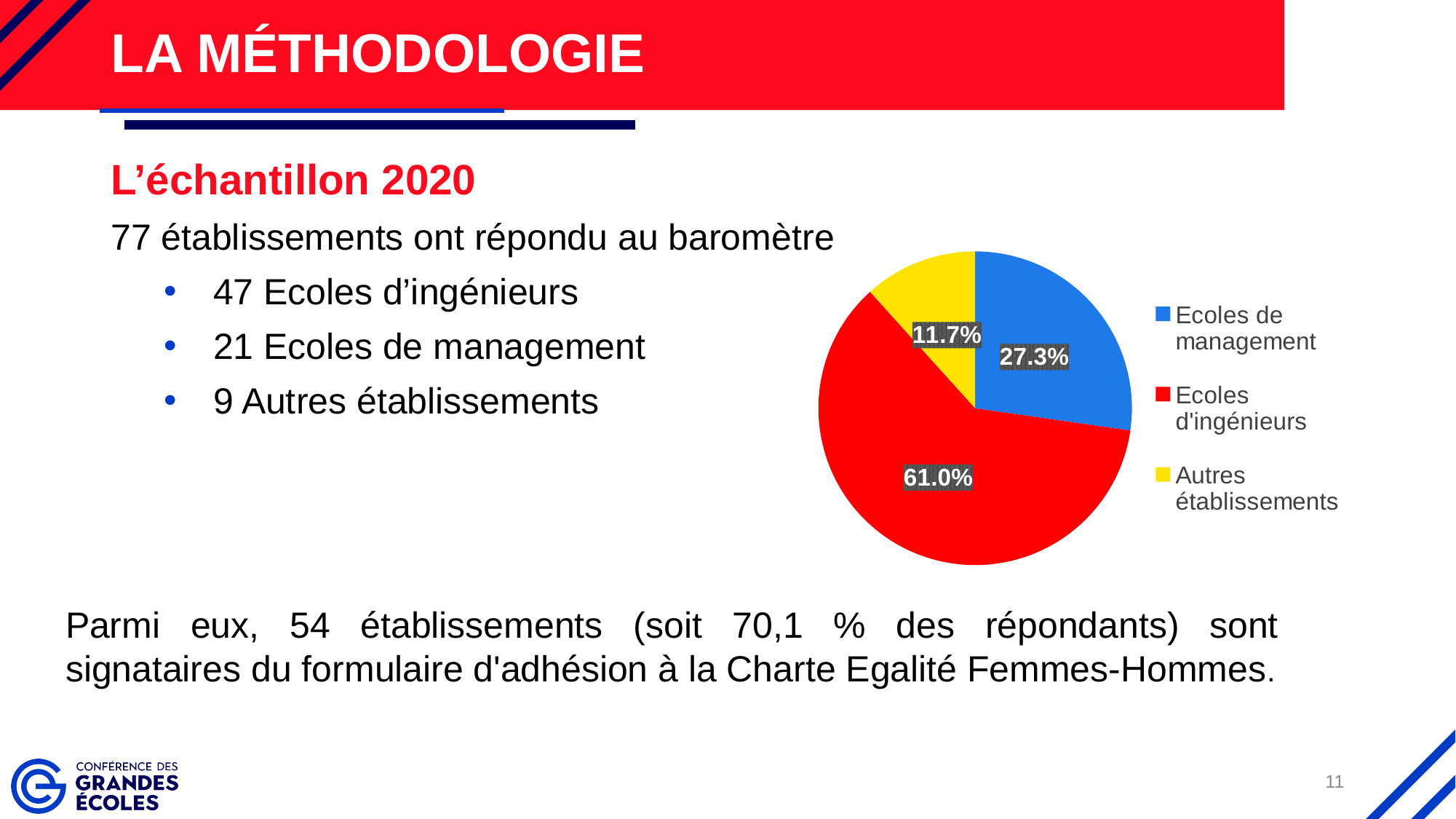
What is the difference in percentage points between the Ecoles d'ingénieurs slice and the Ecoles de management slice? 33.7 What share of the pie does Ecoles de management represent? 27.3% How many entries does the legend list? 3 Which category has the smallest slice of the pie? Autres établissements What is the difference in percentage points between the Ecoles de management slice and the Autres établissements slice? 15.6 Which category has the largest slice of the pie? Ecoles d'ingénieurs What type of chart is shown on the slide? pie chart What share of the pie does Ecoles d'ingénieurs represent? 61.0% How many slices does the pie chart have? 3 What colour is the Ecoles d'ingénieurs slice? red Which slice is larger: Ecoles de management or Autres établissements? Ecoles de management What share of the pie does Autres établissements represent? 11.7%